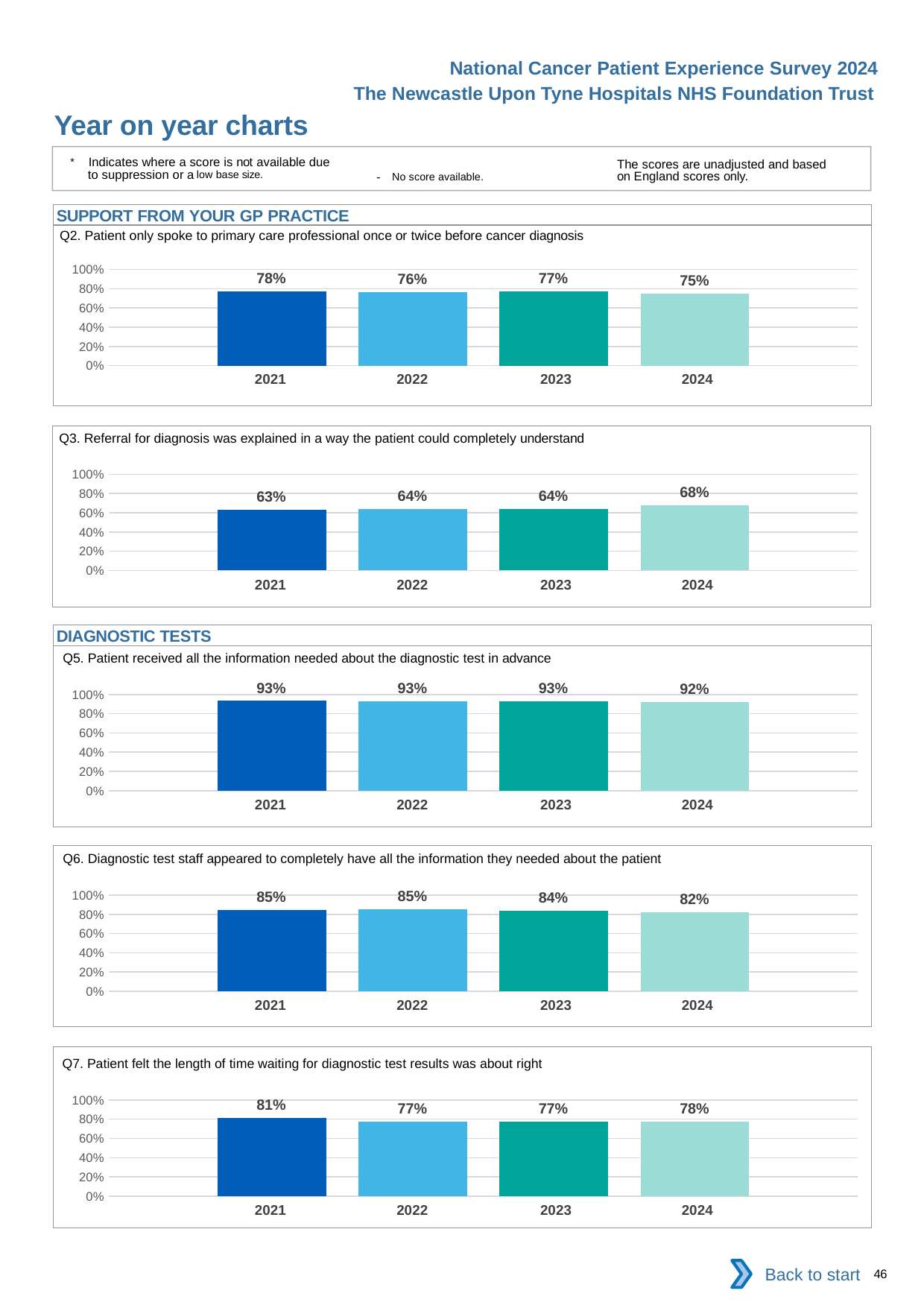
In the Q5 chart, how many years are plotted? 4 In the Q5 chart (patient received all the information needed about the diagnostic test in advance), what is the value for 2024? 92% In the Q6 chart, do the values rise or fall from 2022 to 2024? fall In the Q2 chart (patient only spoke to primary care professional once or twice before cancer diagnosis), what is the value for 2021? 78% What kind of chart is used for the Q7 chart? bar chart In the Q3 chart, which year has the highest value? 2024 In the Q7 chart (patient felt the length of time waiting for diagnostic test results was about right), which year has the highest value? 2021 In the Q6 chart (diagnostic test staff appeared to completely have all the information they needed about the patient), what is the value for 2023? 84% In the Q7 chart, is the value for 2021 larger or smaller than the value for 2022? larger In the Q3 chart (referral for diagnosis was explained in a way the patient could completely understand), what is the value for 2024? 68% In the Q3 chart, what is the difference between the 2024 value and the 2021 value? 5% In the Q2 chart, which year has the lowest value? 2024